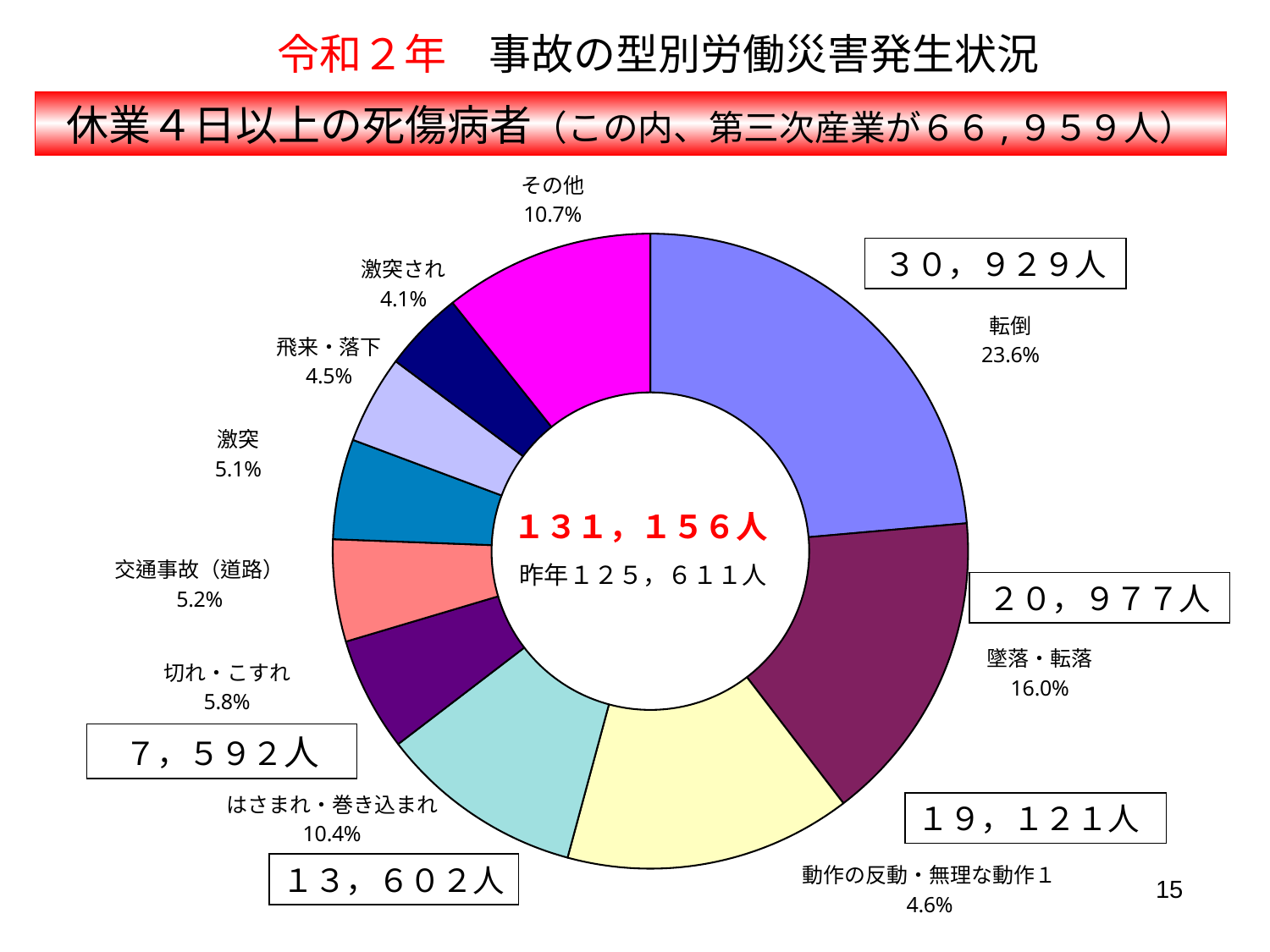
How many people are shown for 墜落・転落? 20,977人 What kind of chart is shown on the slide? doughnut (pie) chart How many people are shown for はさまれ・巻き込まれ? 13,602人 What is the difference in number of people between 転倒 and 墜落・転落? 9,952人 What total number of people is shown in the centre of the chart? 131,156人 What share of the total does 転倒 account for? 23.6% Which is larger, the share for 転倒 or the share for 墜落・転落? 転倒 How many accident-type categories are shown in the chart? 10 Which accident type has the smallest share of the chart? 激突され How many people are shown for 転倒? 30,929人 What percentage is shown for 切れ・こすれ? 5.8% Which accident type has the largest share of the chart? 転倒